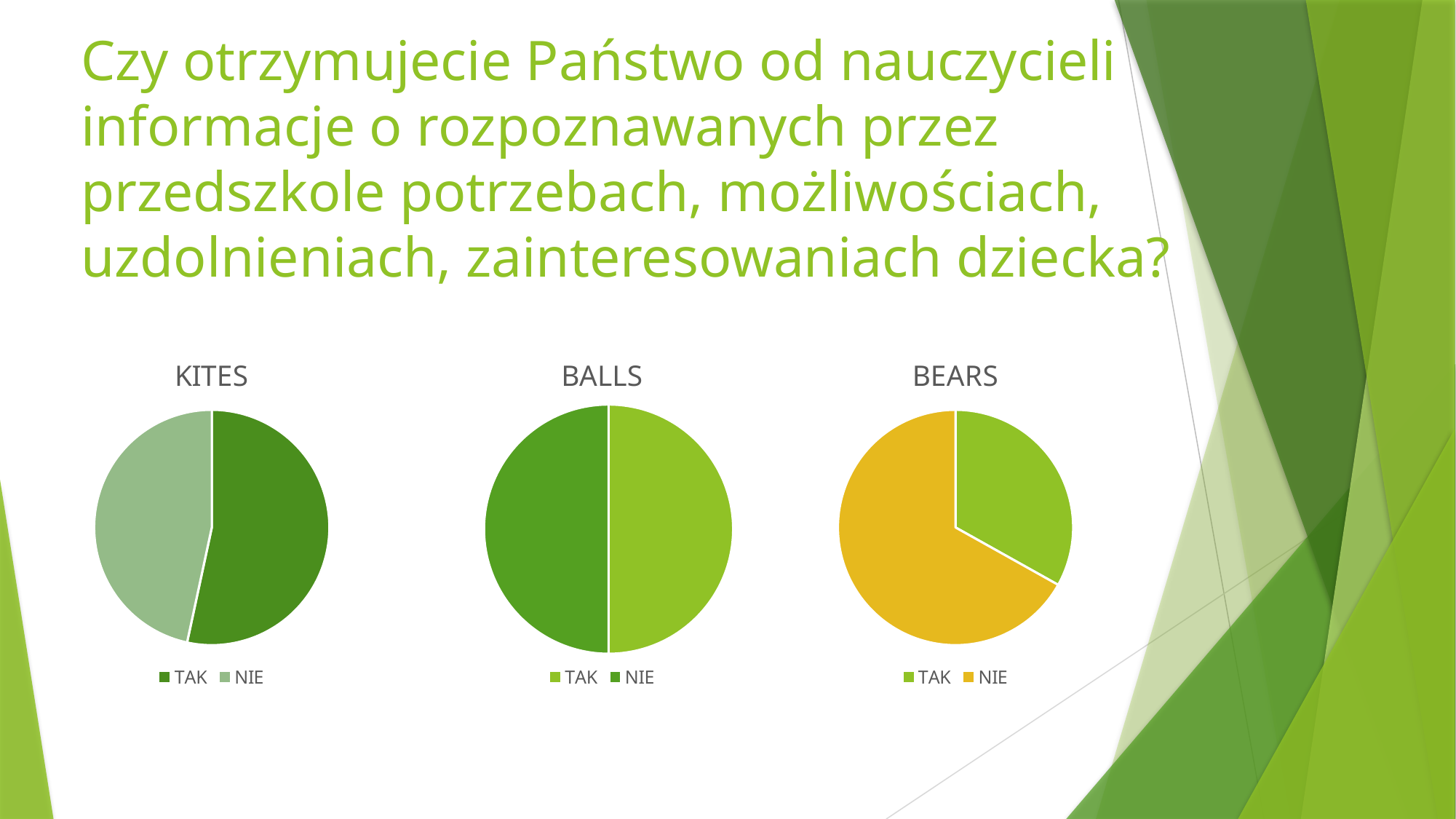
How many slices does the BEARS pie chart have? 2 In the BEARS chart, which category has the smallest slice? TAK How many entries does the legend of the KITES chart list? 2 How many entries does the legend of the BEARS chart list? 2 In the BEARS chart, which slice is larger, TAK or NIE? NIE In the BEARS chart, what colour is the NIE slice? yellow In the BEARS chart, which category has the largest slice? NIE How many slices does the BALLS pie chart have? 2 What kind of chart is the BEARS chart? pie chart What kind of chart is the KITES chart? pie chart What are the titles of the three pie charts on the slide, from left to right? KITES, BALLS, BEARS